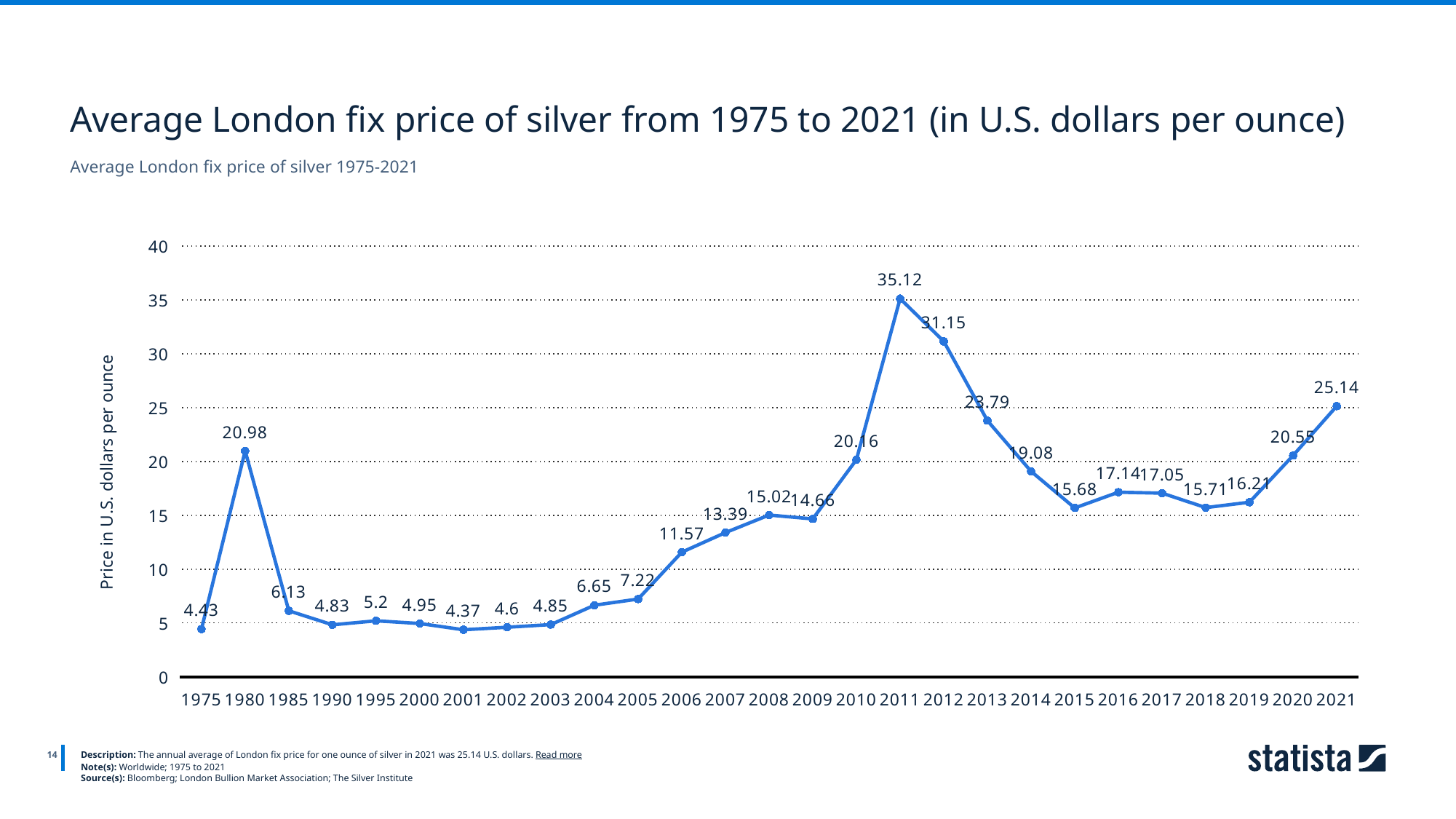
Which year has the highest average London fix price of silver? 2011 What is the label of the y axis? Price in U.S. dollars per ounce Is the value for 2010 greater or less than 25? less What is the difference between the silver price in 2011 and in 2012? 3.97 How many years are plotted on the chart? 27 What was the average London fix price of silver in 2011? 35.12 Did the silver price rise or fall from 2011 to 2015? fall Which year has the lowest average London fix price of silver? 2001 What was the average London fix price of silver in 2021? 25.14 What was the average London fix price of silver in 1980? 20.98 What kind of chart is shown on the slide? line chart Which year had a higher silver price, 2013 or 2020? 2013